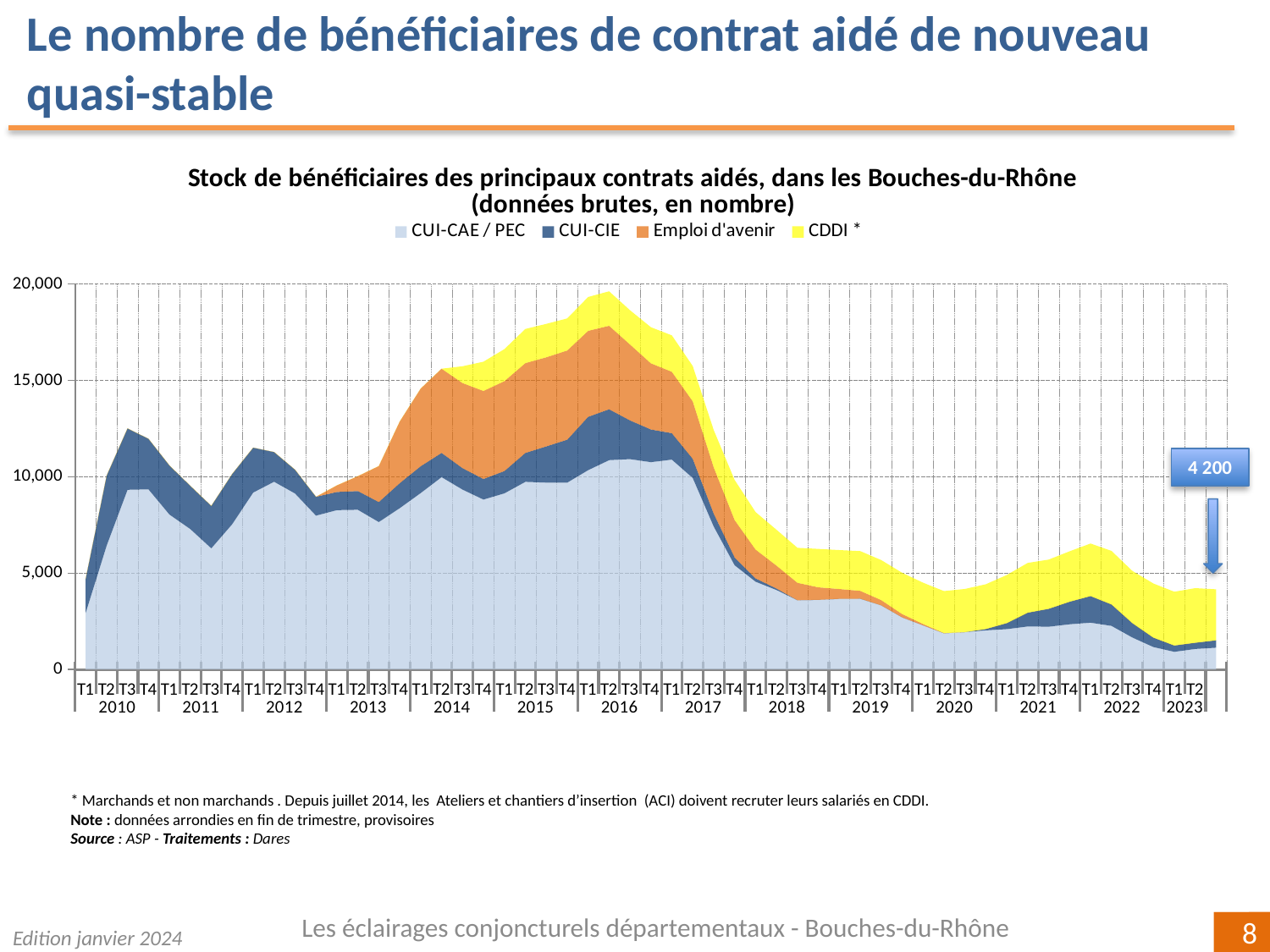
Is the total stock of beneficiaries in T2 2016 greater or less than 15,000? greater Is the total stock of beneficiaries in T2 2020 greater or less than 5,000? less In which year does the total stock of beneficiaries reach its highest level? 2016 Which series forms the bottom layer of the stacked area? CUI-CAE / PEC Does the total stock of beneficiaries rise or fall between 2017 and 2020? fall How many series does the legend list? 4 Which series is shown in yellow? CDDI * What value is printed in the callout at the right end of the chart? 4 200 Is the total stock of beneficiaries in T3 2010 greater or less than 10,000? greater Which is larger, the total stock of beneficiaries in T2 2016 or in T2 2023? T2 2016 How many years are labelled on the x axis? 14 What kind of chart is shown on the slide? stacked area chart